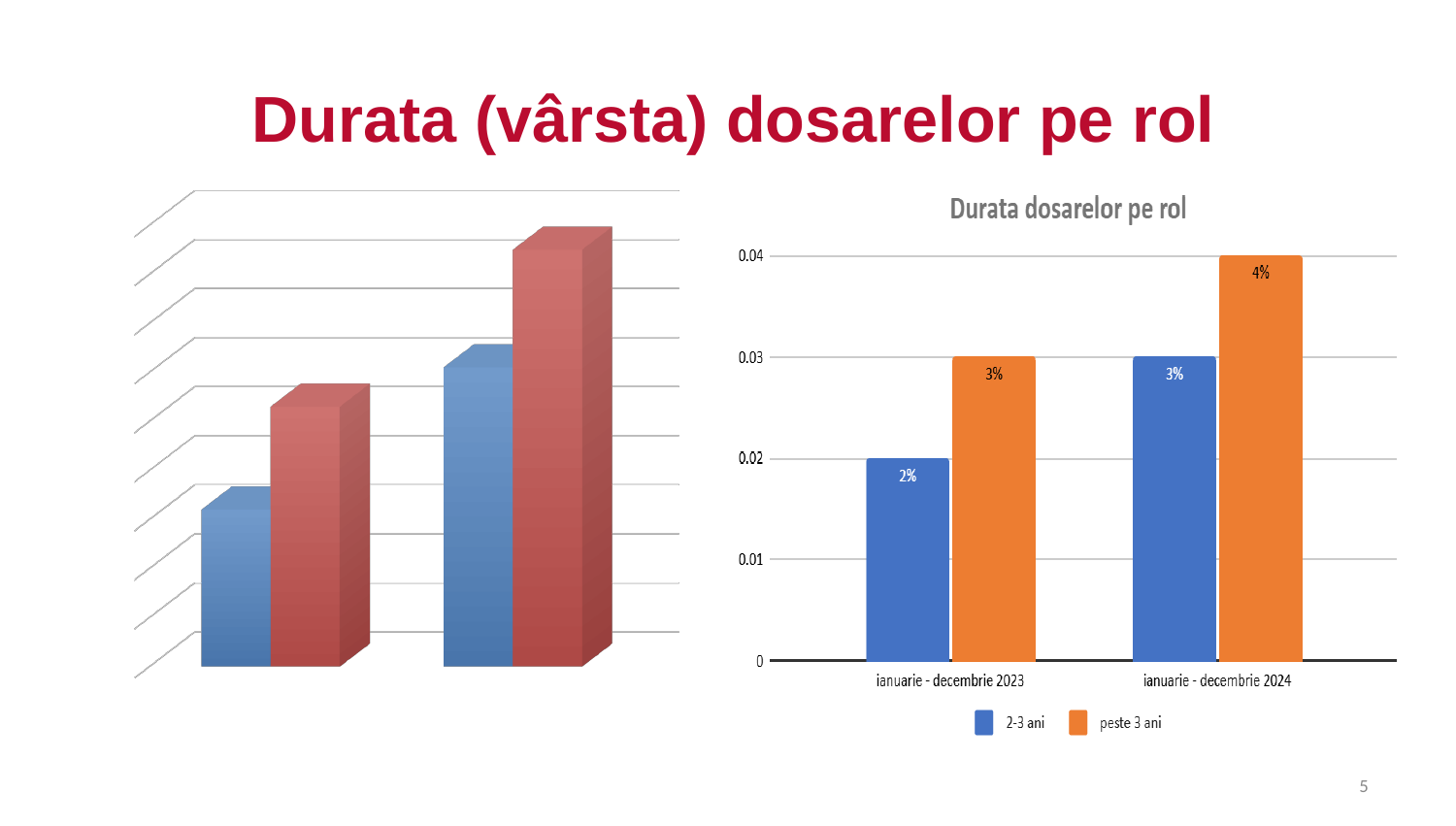
In the chart titled "Durata dosarelor pe rol", what is the value for "peste 3 ani" in "ianuarie - decembrie 2023"? 3% In the chart titled "Durata dosarelor pe rol", which bar has the highest value? peste 3 ani, ianuarie - decembrie 2024 In the chart titled "Durata dosarelor pe rol", is the value for "2-3 ani" larger in "ianuarie - decembrie 2023" or in "ianuarie - decembrie 2024"? ianuarie - decembrie 2024 In the chart titled "Durata dosarelor pe rol", what is the difference between "peste 3 ani" and "2-3 ani" in "ianuarie - decembrie 2024"? 1% In the chart titled "Durata dosarelor pe rol", how many categories are shown on the x axis? 2 In the chart titled "Durata dosarelor pe rol", does the value for "peste 3 ani" rise or fall from 2023 to 2024? rise In the chart titled "Durata dosarelor pe rol", what is the value for "2-3 ani" in "ianuarie - decembrie 2024"? 3% What kind of chart is the chart on the left side of the slide? bar chart In the chart titled "Durata dosarelor pe rol", which bar has the lowest value? 2-3 ani, ianuarie - decembrie 2023 In the chart titled "Durata dosarelor pe rol", how many series does the legend list? 2 In the chart titled "Durata dosarelor pe rol", what is the value for "2-3 ani" in "ianuarie - decembrie 2023"? 2% In the chart titled "Durata dosarelor pe rol", what is the value for "peste 3 ani" in "ianuarie - decembrie 2024"? 4%